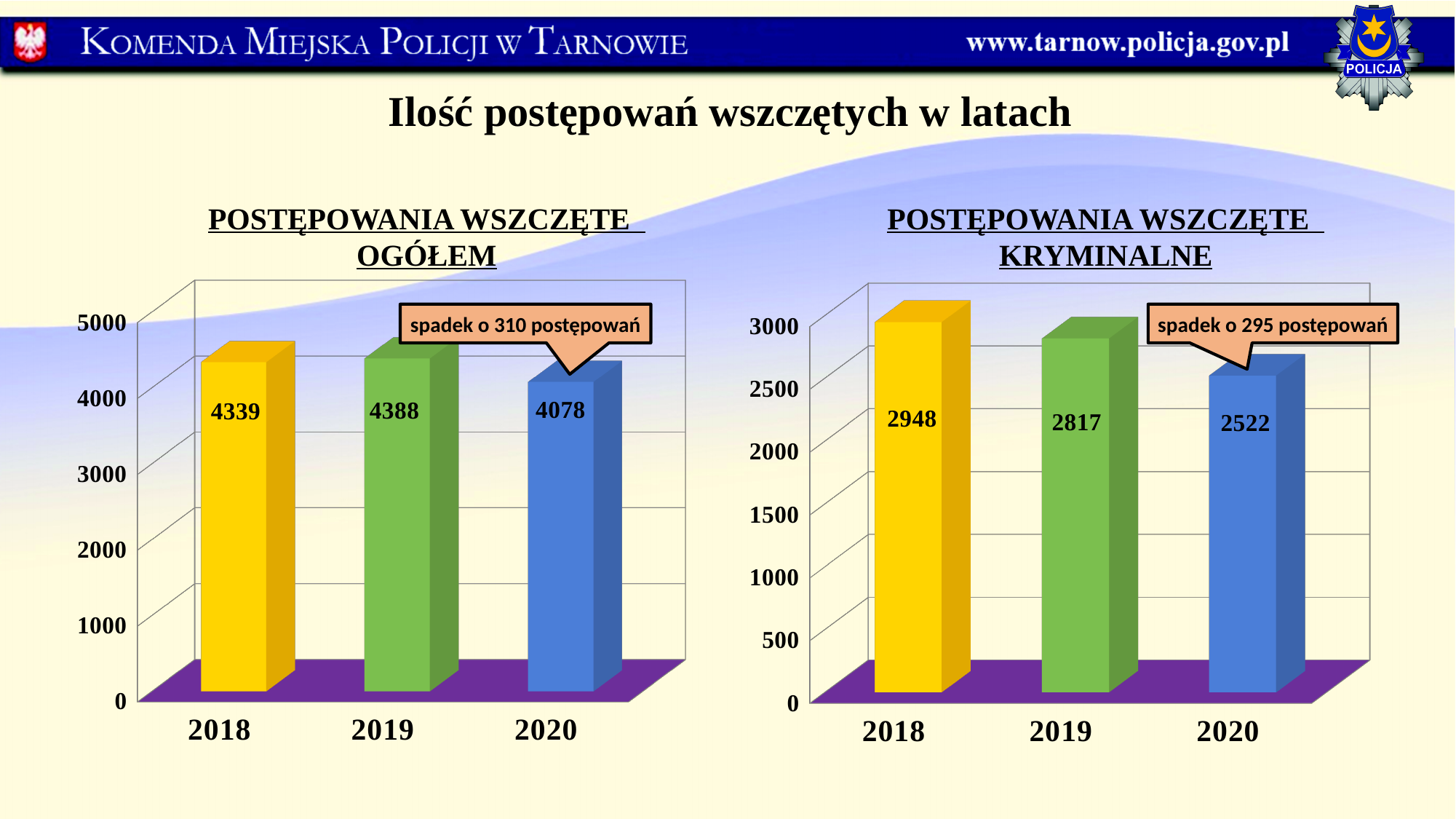
In the chart titled 'POSTĘPOWANIA WSZCZĘTE KRYMINALNE', which year has the lowest value? 2020 In the chart titled 'POSTĘPOWANIA WSZCZĘTE OGÓŁEM', which year has the highest value? 2019 In the chart titled 'POSTĘPOWANIA WSZCZĘTE OGÓŁEM', what is the value for 2020? 4078 In the chart titled 'POSTĘPOWANIA WSZCZĘTE OGÓŁEM', what is the difference between the values for 2019 and 2020? 310 What kind of chart is the chart titled 'POSTĘPOWANIA WSZCZĘTE KRYMINALNE'? bar chart In the chart titled 'POSTĘPOWANIA WSZCZĘTE KRYMINALNE', do the values rise or fall from 2018 to 2020? fall How many years are shown in the chart titled 'POSTĘPOWANIA WSZCZĘTE OGÓŁEM'? 3 In the chart titled 'POSTĘPOWANIA WSZCZĘTE KRYMINALNE', what is the value for 2019? 2817 In the chart titled 'POSTĘPOWANIA WSZCZĘTE KRYMINALNE', what is the value for 2020? 2522 In the chart titled 'POSTĘPOWANIA WSZCZĘTE KRYMINALNE', which is larger, the value for 2018 or the value for 2020? 2018 In the chart titled 'POSTĘPOWANIA WSZCZĘTE KRYMINALNE', what is the difference between the values for 2018 and 2019? 131 In the chart titled 'POSTĘPOWANIA WSZCZĘTE OGÓŁEM', what is the value for 2018? 4339